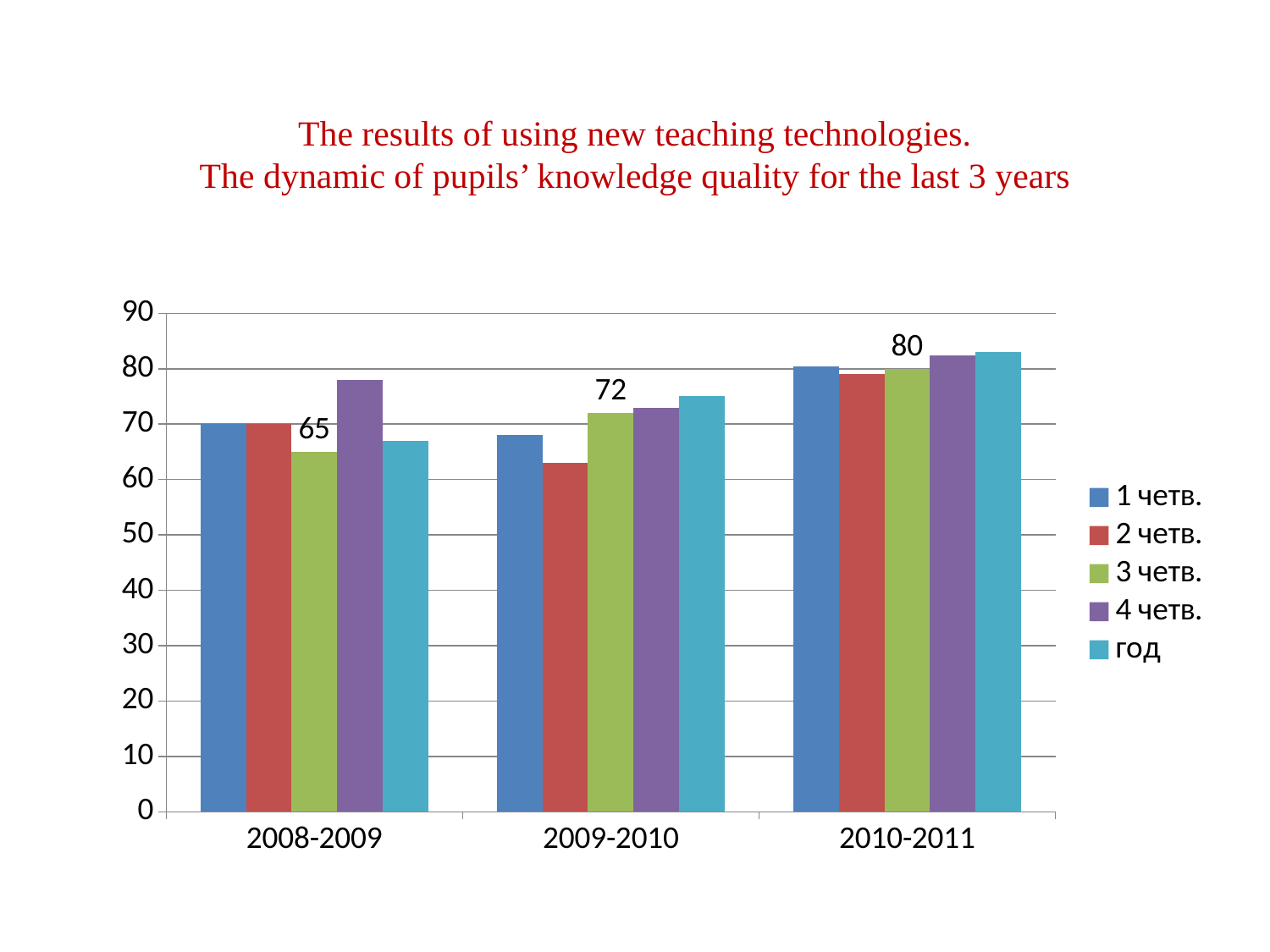
What is the value of the 3 четв. series for 2008-2009? 65 Is the value of the 2 четв. series for 2009-2010 greater or less than 70? less What kind of chart is shown on the slide? bar chart What is the value of the 3 четв. series for 2009-2010? 72 By how much did the 3 четв. value increase from 2008-2009 to 2010-2011? 15 What is the value of the 3 четв. series for 2010-2011? 80 How many series does the legend list? 5 Does the 3 четв. series rise or fall from 2008-2009 to 2010-2011? rise Is the value of the год series for 2010-2011 greater or less than 80? greater How many school years are shown on the x axis? 3 What is the difference between the 3 четв. values for 2009-2010 and 2008-2009? 7 Which series has the highest value in the 2008-2009 group? 4 четв.